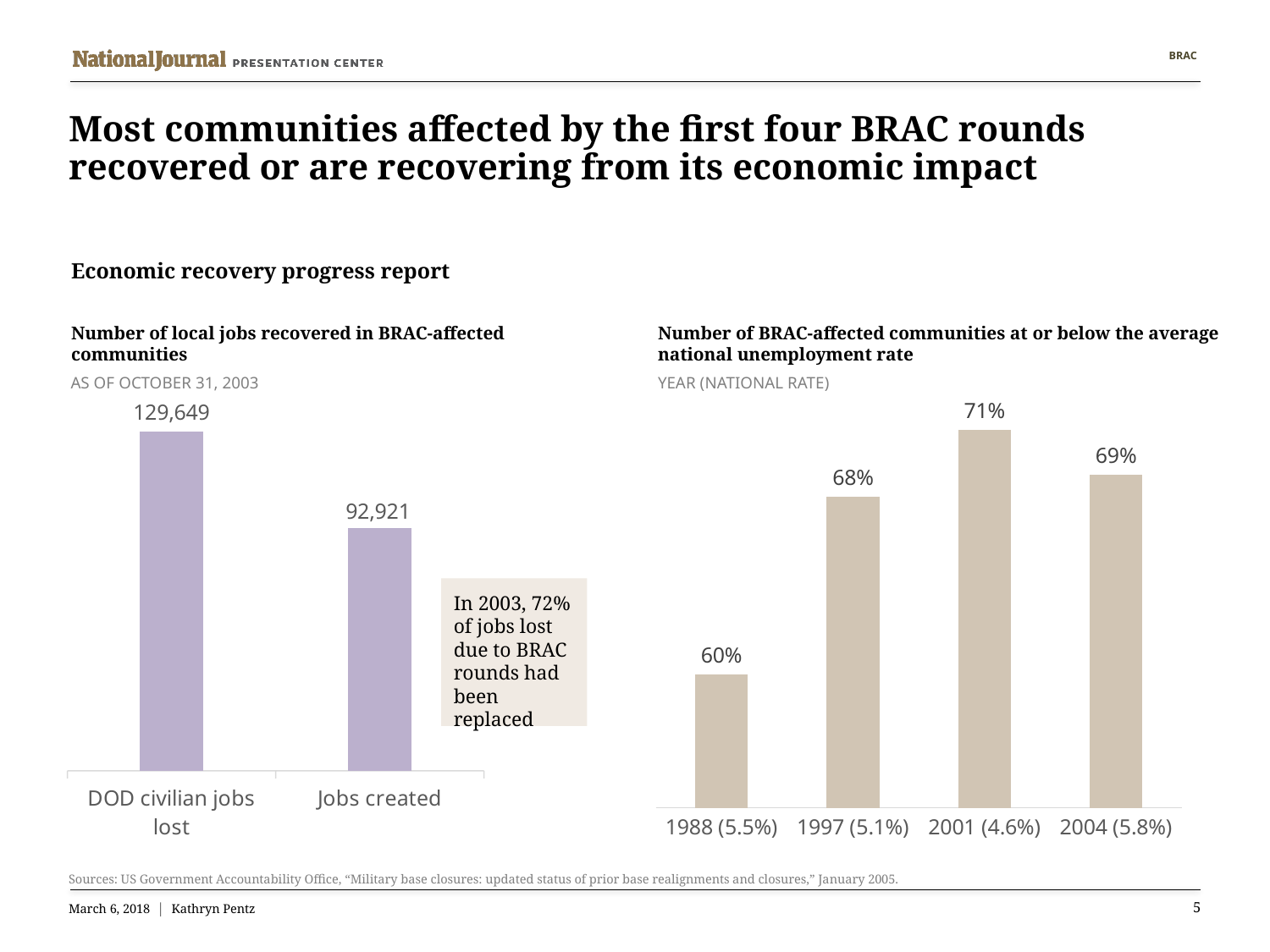
In the left chart (Number of local jobs recovered in BRAC-affected communities), what is the difference between DOD civilian jobs lost and Jobs created? 36,728 In the right chart (Number of BRAC-affected communities at or below the average national unemployment rate), which is larger, the value for 1997 (5.1%) or the value for 2004 (5.8%)? 2004 (5.8%) In the right chart (Number of BRAC-affected communities at or below the average national unemployment rate), how many years are plotted? 4 In the left chart (Number of local jobs recovered in BRAC-affected communities), what is the value for Jobs created? 92,921 In the right chart (Number of BRAC-affected communities at or below the average national unemployment rate), what is the value for 1988 (5.5%)? 60% In the right chart (Number of BRAC-affected communities at or below the average national unemployment rate), which year has the lowest value? 1988 (5.5%) In the right chart (Number of BRAC-affected communities at or below the average national unemployment rate), what is the difference between the values for 2001 (4.6%) and 1988 (5.5%)? 11% In the right chart (Number of BRAC-affected communities at or below the average national unemployment rate), what is the value for 2001 (4.6%)? 71% In the left chart (Number of local jobs recovered in BRAC-affected communities), what is the value for DOD civilian jobs lost? 129,649 What kind of chart is the right chart (Number of BRAC-affected communities at or below the average national unemployment rate)? Bar chart In the left chart (Number of local jobs recovered in BRAC-affected communities), how many categories are plotted? 2 In the right chart (Number of BRAC-affected communities at or below the average national unemployment rate), which year has the highest value? 2001 (4.6%)